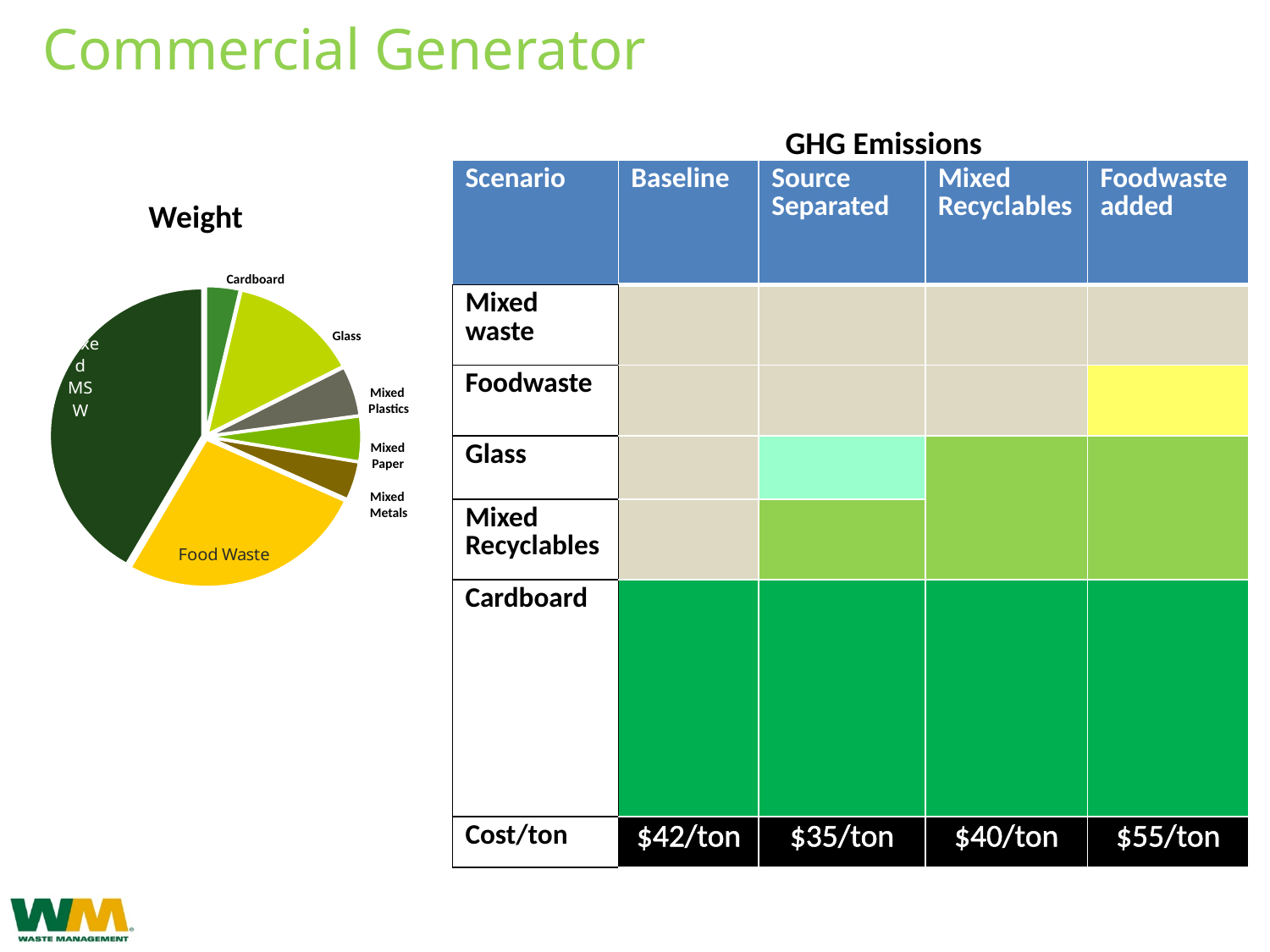
What colour is the Food Waste slice in the "Weight" pie chart? yellow How many slices does the "Weight" pie chart have? 7 What kind of chart is the "Weight" chart on the slide? pie chart In the "Weight" pie chart, which slice is larger, Cardboard or Food Waste? Food Waste In the "Weight" pie chart, which slice is larger, Food Waste or Glass? Food Waste What is the title of the pie chart on the slide? Weight In the "Weight" pie chart, which slice is larger, Glass or Mixed Plastics? Glass